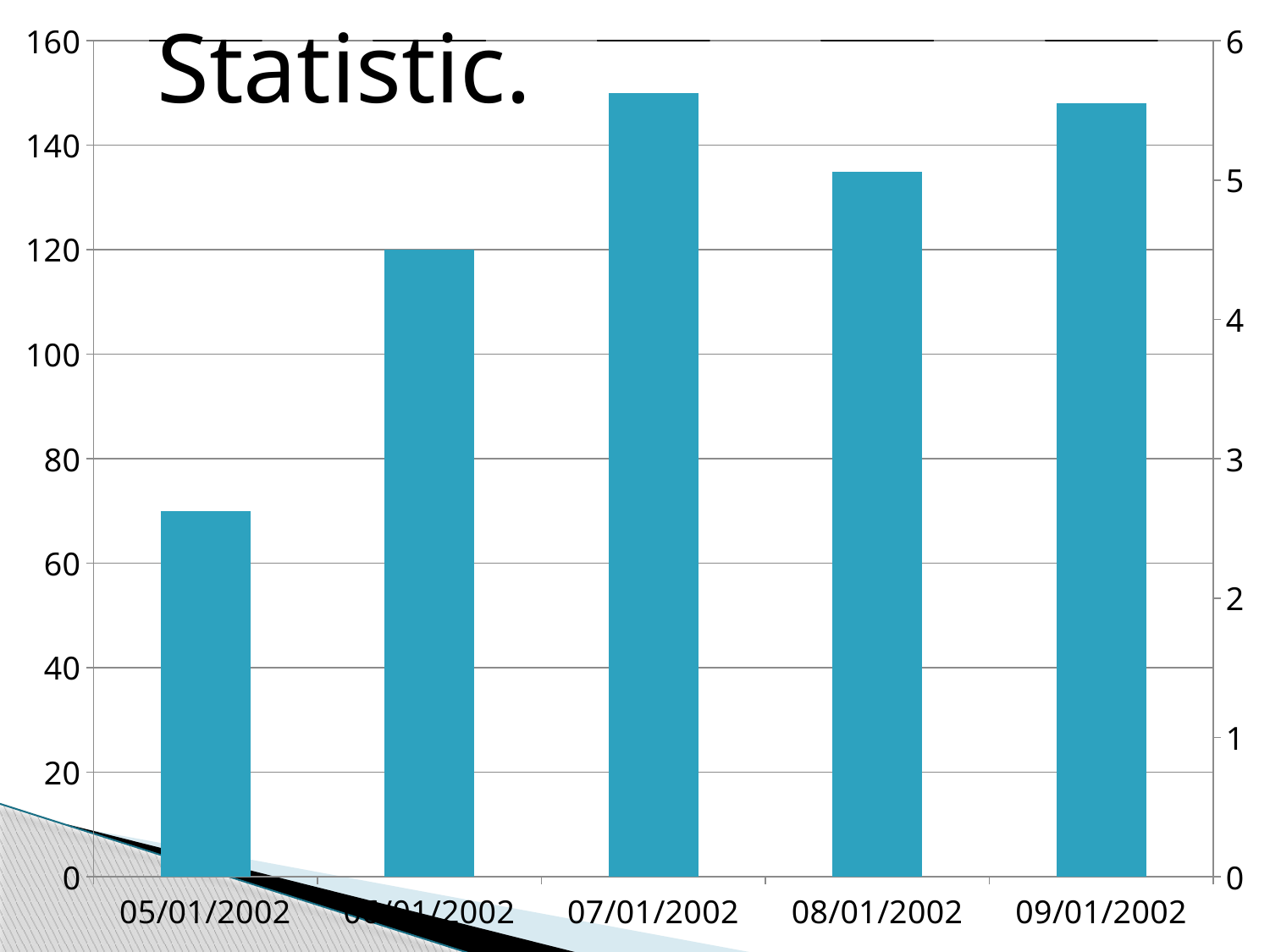
Which is larger, the value for 07/01/2002 or the value for 08/01/2002? 07/01/2002 What kind of chart is shown on the slide? bar chart Is the value for 05/01/2002 greater or less than 80? less What is the title shown on the slide? Statistic. Do the values rise or fall from 05/01/2002 to 07/01/2002? rise Is the value for 08/01/2002 greater or less than 140? less Is the value for 07/01/2002 greater or less than 140? greater How many bars are plotted in the chart? 5 Which category has the lowest bar? 05/01/2002 Which is larger, the value for 05/01/2002 or the value for 08/01/2002? 08/01/2002